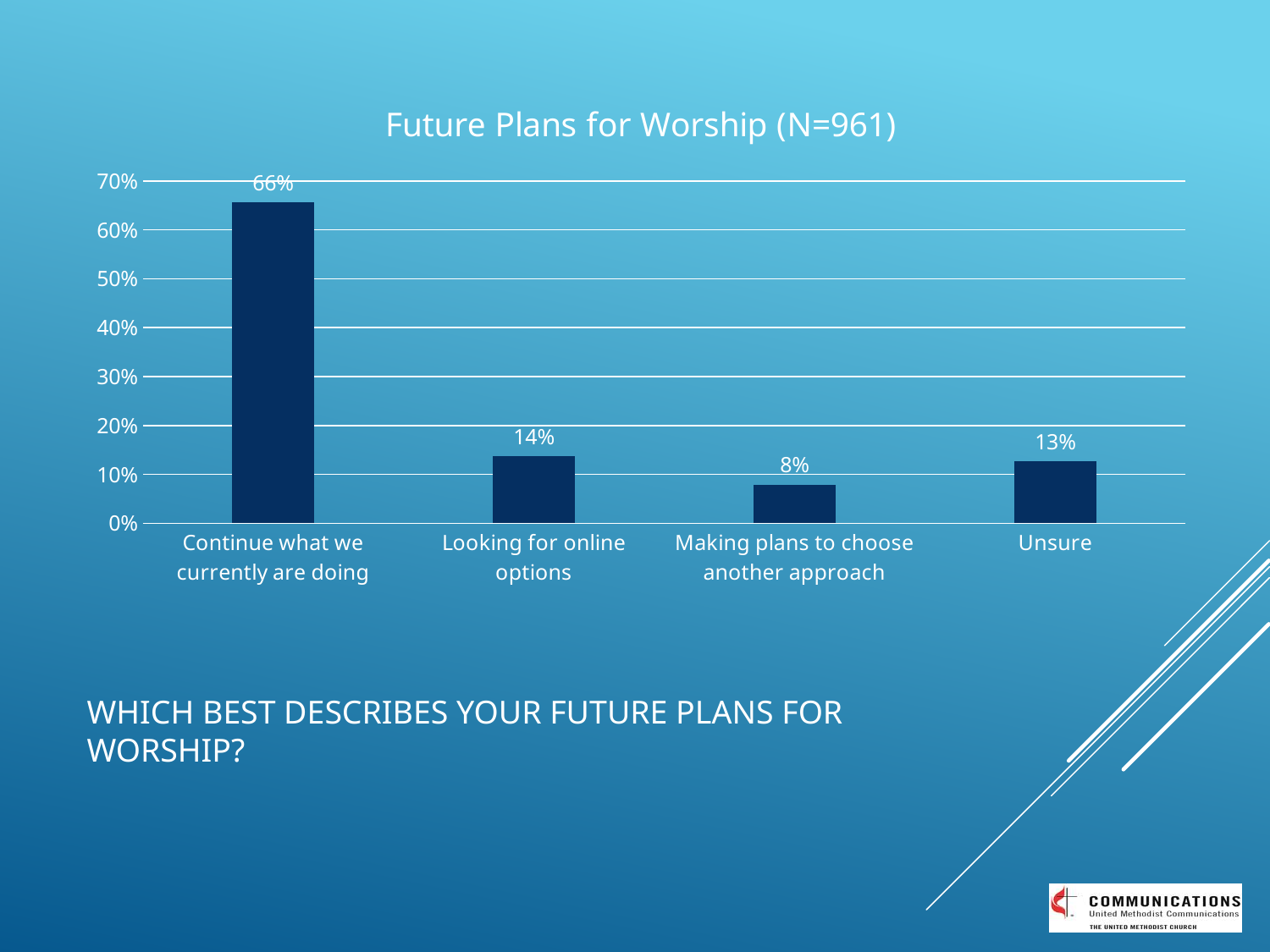
Is the value for 'Continue what we currently are doing' greater or less than 60%? greater Which is larger: 'Looking for online options' or 'Unsure'? Looking for online options What kind of chart is shown on the slide? Bar chart What percentage of respondents plan to continue what they currently are doing? 66% What is the title of the chart? Future Plans for Worship (N=961) What is the difference between 'Continue what we currently are doing' and 'Looking for online options'? 52% How many categories are shown in the chart? 4 What is the value for 'Making plans to choose another approach'? 8% Which category has the highest value? Continue what we currently are doing What percentage of respondents are Unsure? 13% What is the value for 'Looking for online options'? 14% Which category has the lowest value? Making plans to choose another approach